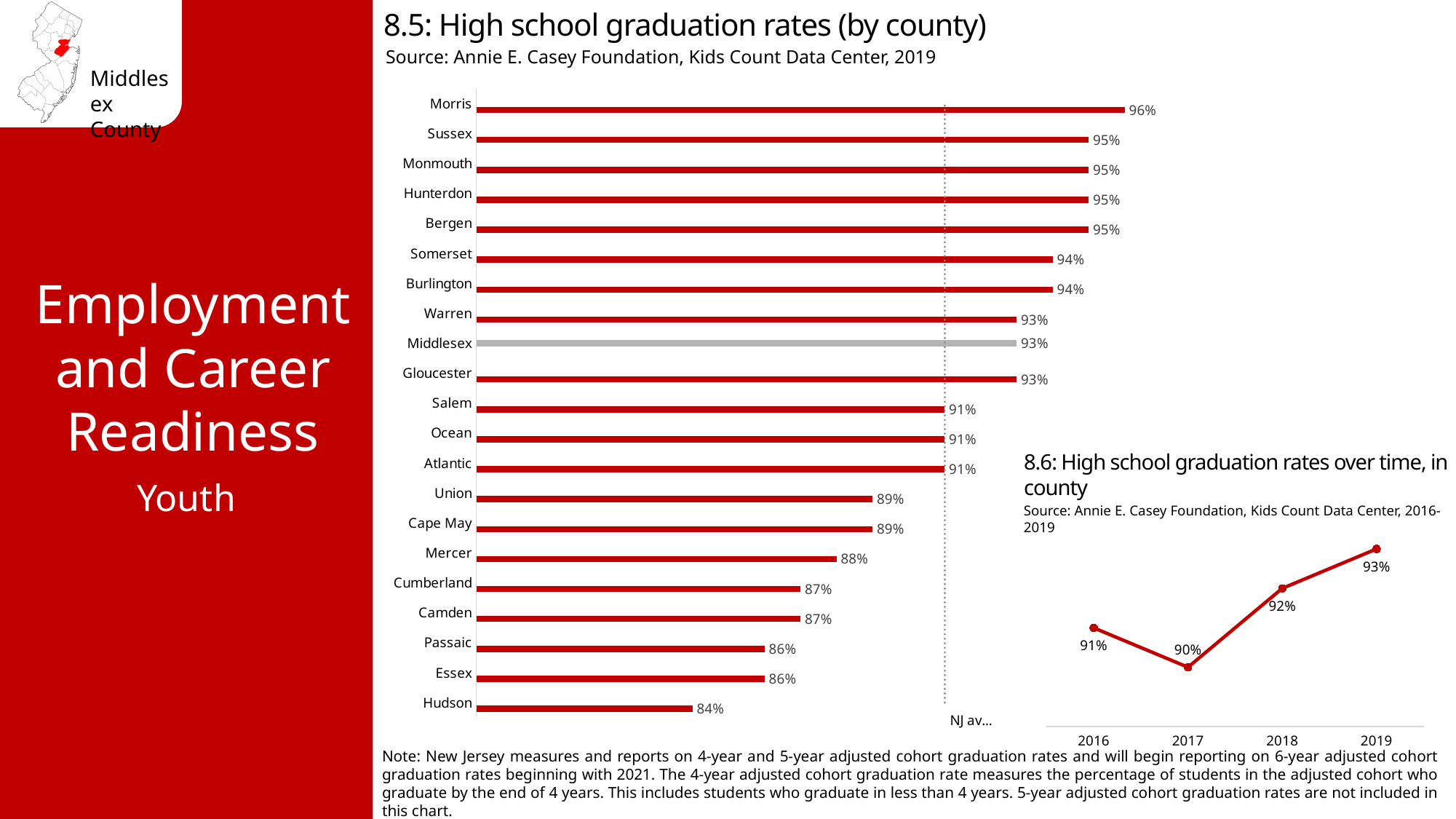
What kind of chart is '8.6: High school graduation rates over time, in county'? Line chart What kind of chart is '8.5: High school graduation rates (by county)'? Bar chart In the chart '8.5: High school graduation rates (by county)', which county has the highest graduation rate? Morris In the chart '8.5: High school graduation rates (by county)', which has a higher graduation rate, Mercer or Passaic? Mercer In the chart '8.5: High school graduation rates (by county)', what is the graduation rate for Cape May? 89% In the chart '8.5: High school graduation rates (by county)', what is the difference between the graduation rates of Morris and Hudson? 12% In the chart '8.5: High school graduation rates (by county)', which county has the lowest graduation rate? Hudson In the chart '8.5: High school graduation rates (by county)', what is the graduation rate for Middlesex? 93% In the chart '8.6: High school graduation rates over time, in county', what is the difference between the 2019 and 2016 graduation rates? 2% In the chart '8.5: High school graduation rates (by county)', how many counties are shown? 21 In the chart '8.6: High school graduation rates over time, in county', which year has the highest graduation rate? 2019 In the chart '8.6: High school graduation rates over time, in county', what is the graduation rate for 2017? 90%